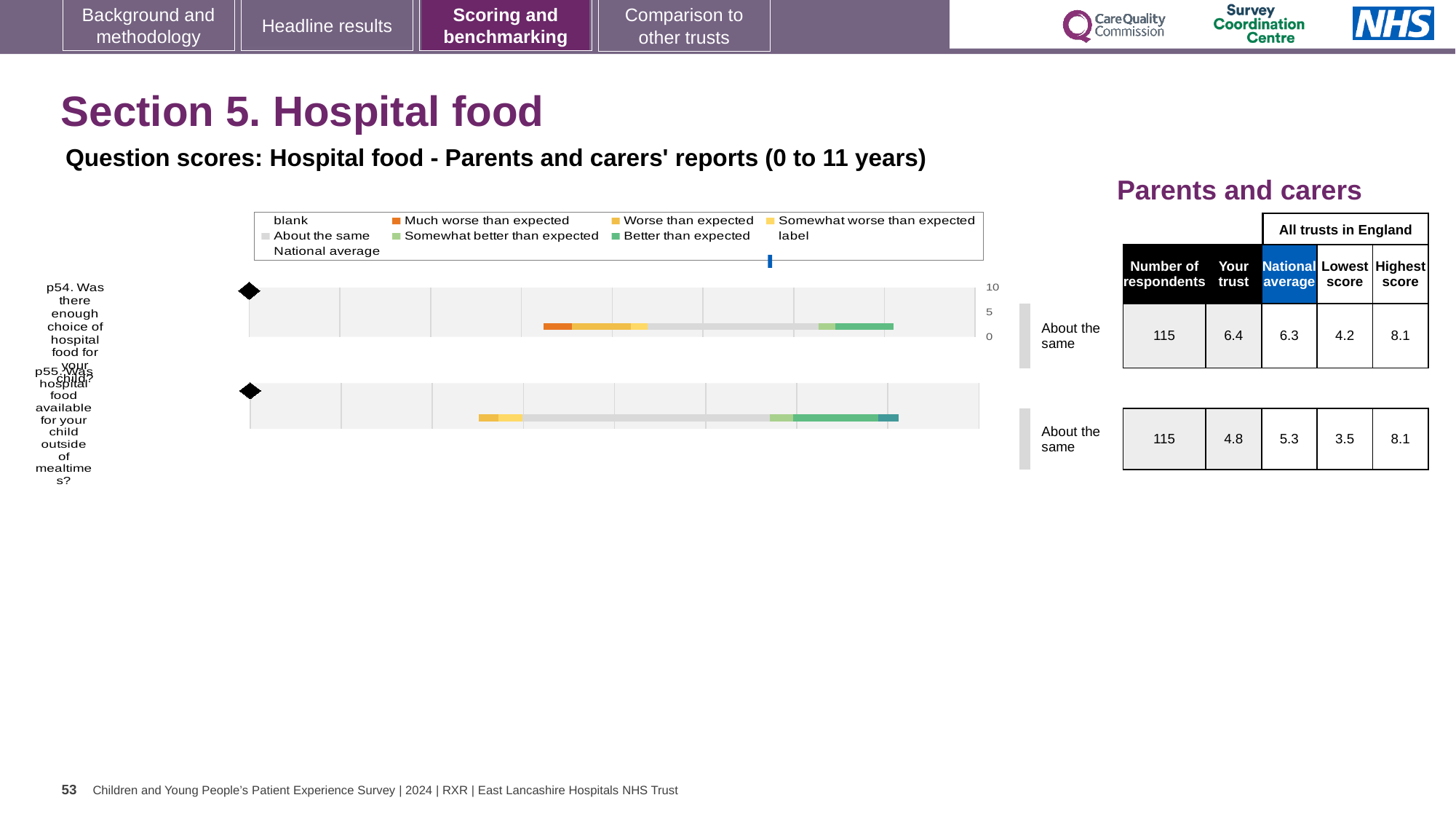
For p54, what is the difference between the highest and lowest scores among all trusts in England? 3.9 For p54, which is larger: the 'Your trust' score or the national average? Your trust What is the national average score for p55 (Was hospital food available for your child outside of mealtimes?)? 5.3 What benchmark category is shown for p55? About the same How many respondents answered p54? 115 What is the lowest score among all trusts in England for p55? 3.5 For p55, what is the difference between the national average and the 'Your trust' score? 0.5 What is the 'Your trust' score for p54 (Was there enough choice of hospital food for your child?)? 6.4 How many survey questions (categories) are plotted in the chart? 2 Which question has the higher 'Your trust' score, p54 or p55? p54 What is the highest score among all trusts in England for p54? 8.1 What kind of chart is shown on the slide? bar chart